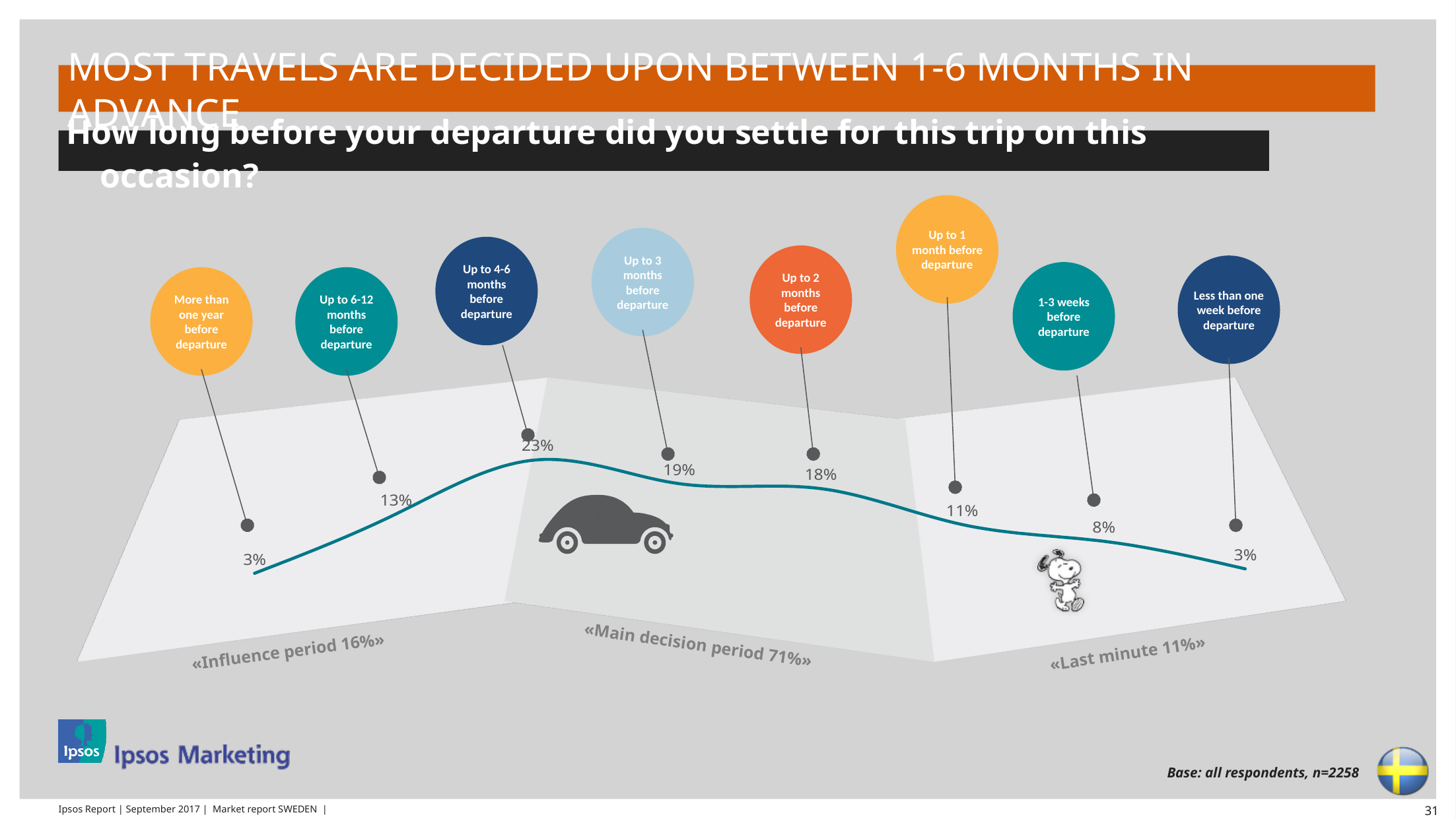
Which time period before departure has the highest share of respondents? Up to 4-6 months before departure What percentage of respondents settled for the trip up to 6-12 months before departure? 13% What kind of chart is used to show the percentages across the time periods? Line chart What is the base (number of respondents) stated on the slide? n=2258 What percentage of respondents settled for the trip up to 2 months before departure? 18% How many time-period categories are plotted on the chart? 8 Which is larger: the share for 'Up to 6-12 months before departure' or the share for '1-3 weeks before departure'? Up to 6-12 months before departure What percentage of respondents settled for the trip up to 4-6 months before departure? 23% From 'Up to 4-6 months before departure' to 'Less than one week before departure', do the values rise or fall? Fall What is the difference in percentage points between 'Up to 3 months before departure' and 'Up to 1 month before departure'? 8 What percentage is given for the 'Main decision period' on the chart? 71% What percentage of respondents settled for the trip 1-3 weeks before departure? 8%